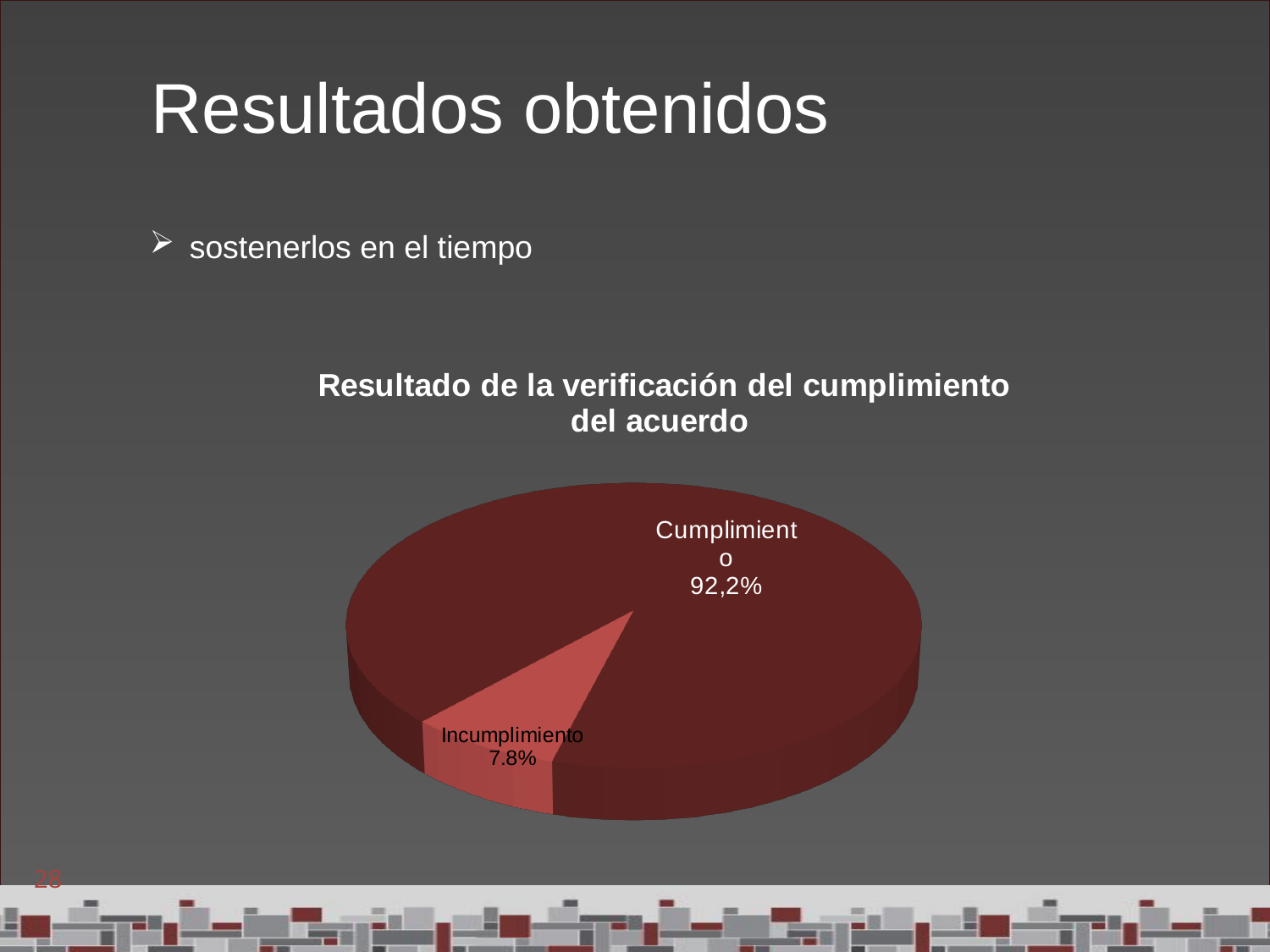
What colour is the Incumplimiento slice compared with the Cumplimiento slice? lighter red Is the share for Incumplimiento greater or less than 10%? less Which slice of the pie is the largest? Cumplimiento How many slices does the pie chart have? 2 Which slice of the pie is the smallest? Incumplimiento What kind of chart is shown on the slide? pie chart What share of the pie is labelled Cumplimiento? 92,2% Is the share for Cumplimiento greater or less than 50%? greater What is the title of the chart? Resultado de la verificación del cumplimiento del acuerdo What share of the pie is labelled Incumplimiento? 7.8% Which is larger, the Cumplimiento slice or the Incumplimiento slice? Cumplimiento